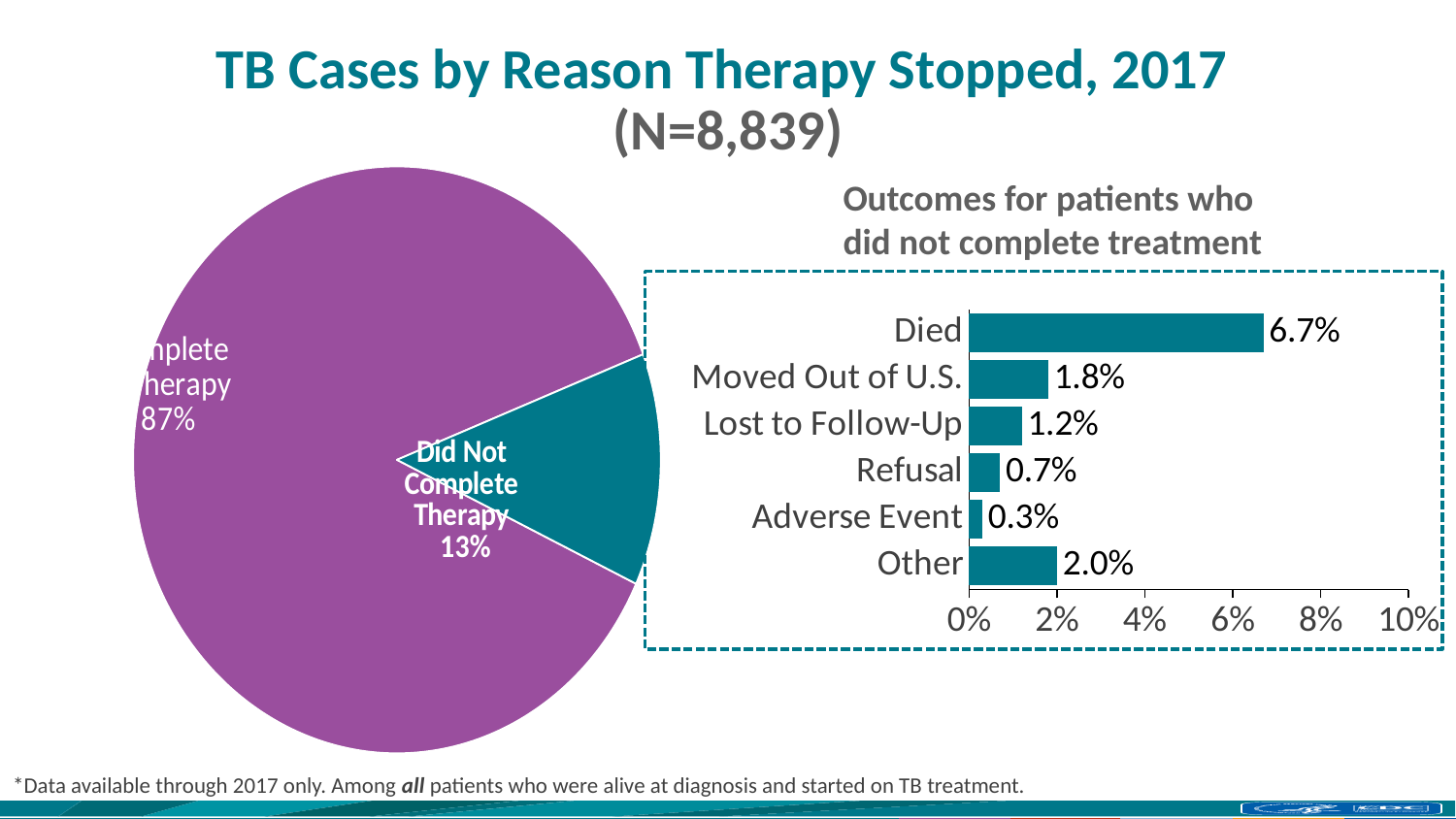
In the bar chart 'Outcomes for patients who did not complete treatment', which is larger: Other or Refusal? Other In the bar chart 'Outcomes for patients who did not complete treatment', what is the value for Adverse Event? 0.3% In the bar chart 'Outcomes for patients who did not complete treatment', what is the difference between the values for Died and Other? 4.7% In the pie chart on the left, what share of TB cases is labeled 'Did Not Complete Therapy'? 13% In the bar chart 'Outcomes for patients who did not complete treatment', which category has the lowest value? Adverse Event In the bar chart 'Outcomes for patients who did not complete treatment', is the value for Died greater or less than 6%? greater How many categories are shown in the bar chart 'Outcomes for patients who did not complete treatment'? 6 In the bar chart 'Outcomes for patients who did not complete treatment', which category has the highest value? Died In the bar chart 'Outcomes for patients who did not complete treatment', what is the value for Lost to Follow-Up? 1.2% In the bar chart 'Outcomes for patients who did not complete treatment', what is the value for Died? 6.7% In the bar chart 'Outcomes for patients who did not complete treatment', what is the value for Moved Out of U.S.? 1.8% What kind of chart is the chart on the left side of the slide? Pie chart